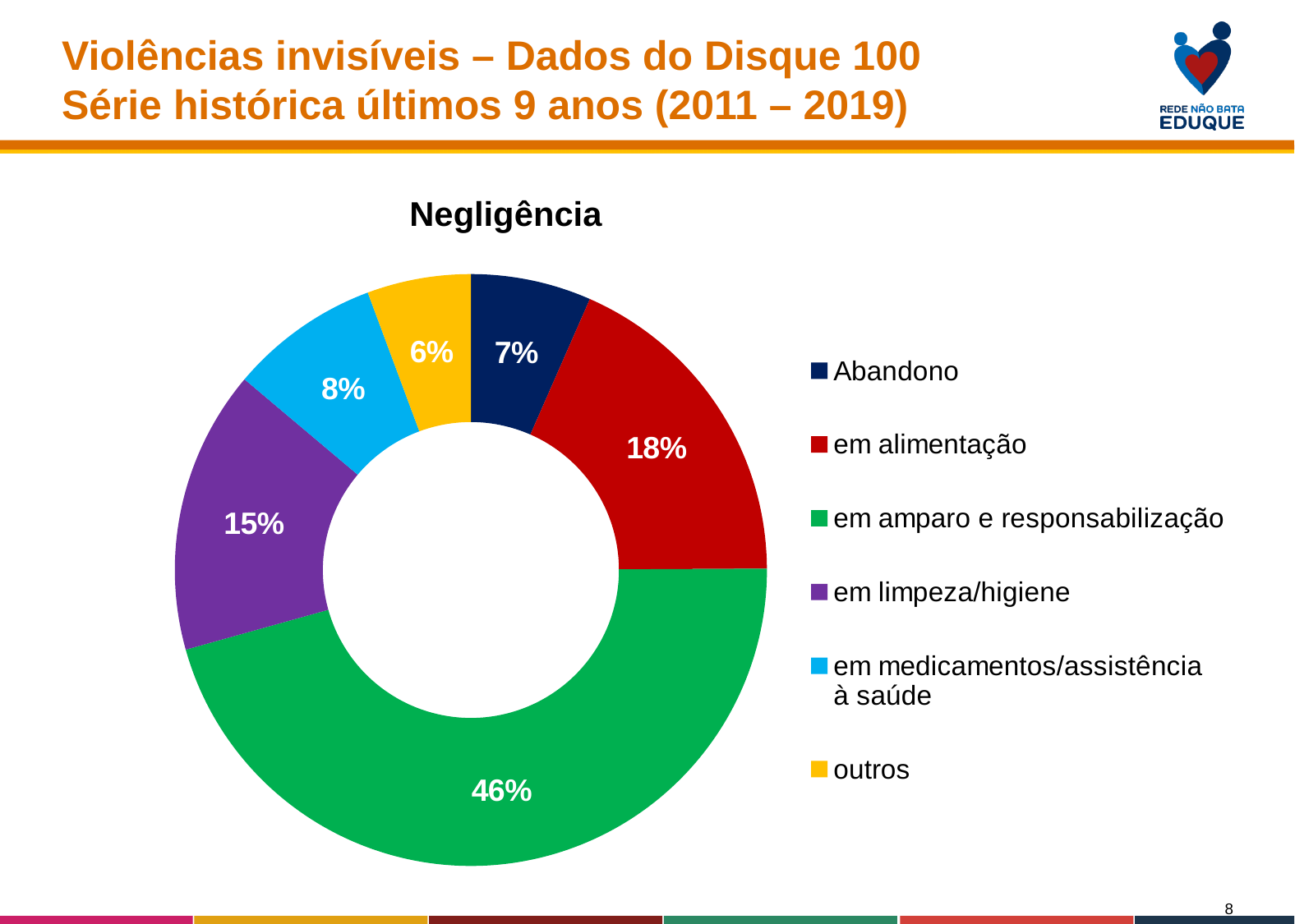
What percentage does the 'em alimentação' slice represent? 18% What type of chart is shown on the slide? Doughnut chart What percentage does the 'em amparo e responsabilização' slice represent? 46% What is the difference in percentage points between 'em amparo e responsabilização' and 'em alimentação'? 28 What percentage does the 'Abandono' slice represent? 7% What is the title of the chart? Negligência What percentage does the 'em medicamentos/assistência à saúde' slice represent? 8% How many categories does the legend list? 6 Which category has the largest share of the chart? em amparo e responsabilização Which category has the smallest share of the chart? outros What percentage does the 'em limpeza/higiene' slice represent? 15% Which is larger, the share for 'em limpeza/higiene' or the share for 'em medicamentos/assistência à saúde'? em limpeza/higiene